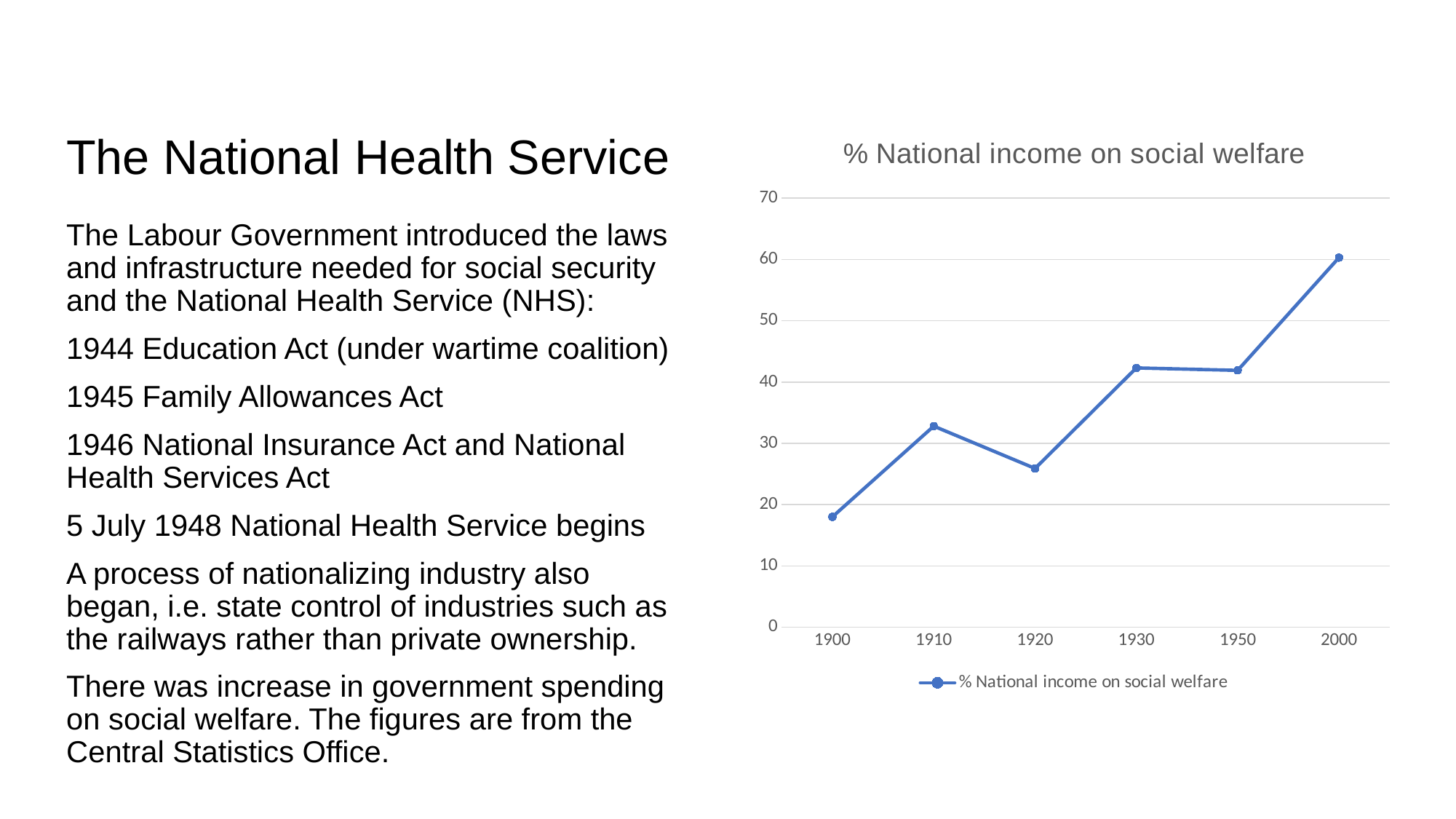
Is the value for 2000 greater or less than 50? greater Is the value for 1900 greater or less than 20? less Is the value for 1920 greater or less than 30? less Which is larger, the value for 1910 or the value for 1920? 1910 How many series does the legend list? 1 How many data points are plotted on the chart? 6 Which year has the lowest value on the chart? 1900 What kind of chart is shown on the slide? line chart Which year has the highest value on the chart? 2000 Overall, do the values rise or fall from 1900 to 2000? rise What is the title of the chart? % National income on social welfare